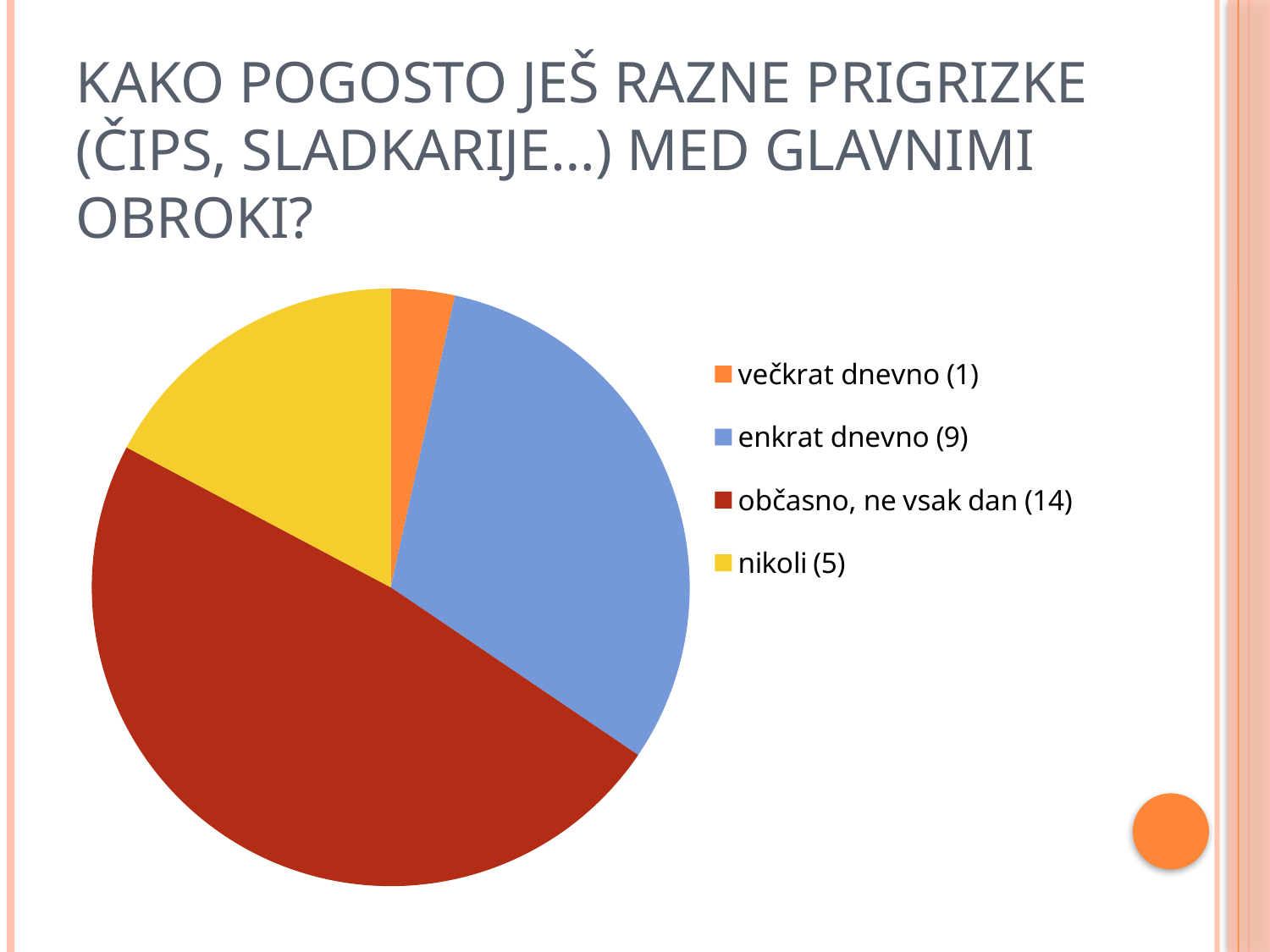
What is the total number of respondents across all slices of the pie? 29 Which category has the smallest slice of the pie? večkrat dnevno How many respondents answered "večkrat dnevno"? 1 What is the difference between the number of respondents for "občasno, ne vsak dan" and "enkrat dnevno"? 5 Which has more respondents, "enkrat dnevno" or "nikoli"? enkrat dnevno How many categories does the pie chart have? 4 How many respondents answered "enkrat dnevno"? 9 How many respondents answered "nikoli"? 5 What kind of chart is shown on the slide? pie chart Which category has the largest slice of the pie? občasno, ne vsak dan How many respondents answered "občasno, ne vsak dan"? 14 What colour is the slice for "nikoli"? yellow